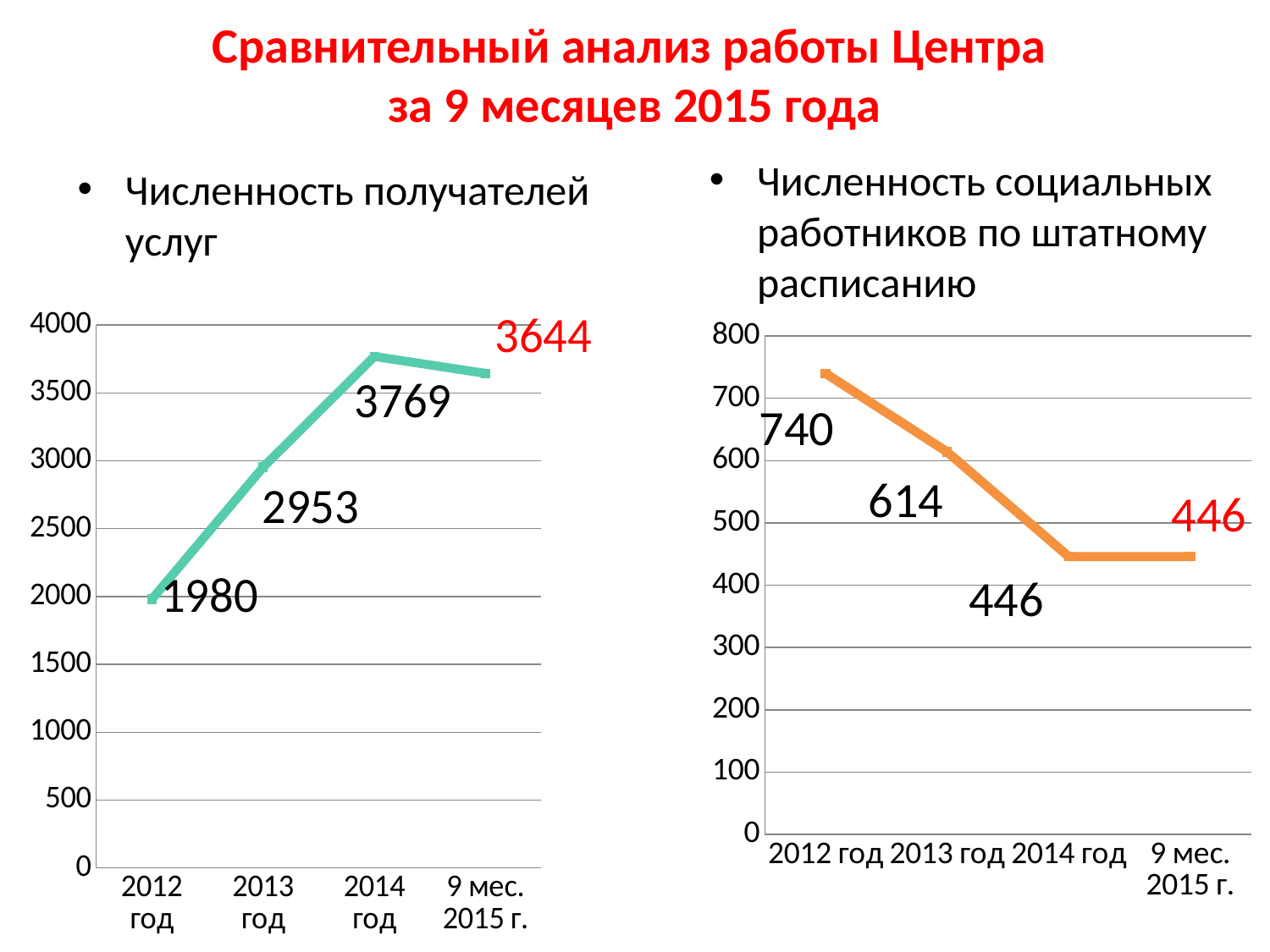
What kind of chart is the right chart (Численность социальных работников по штатному расписанию)? line chart On the right chart (Численность социальных работников по штатному расписанию), what is the difference between the values for 2012 год and 2014 год? 294 On the left chart (Численность получателей услуг), what is the value for 2013 год? 2953 On the left chart (Численность получателей услуг), what is the difference between the values for 2014 год and 2012 год? 1789 On the left chart (Численность получателей услуг), how many data points are plotted? 4 On the right chart (Численность социальных работников по штатному расписанию), do the values rise or fall from 2012 год to 2014 год? fall On the left chart (Численность получателей услуг), which category has the highest value? 2014 год On the right chart (Численность социальных работников по штатному расписанию), what is the value for 2012 год? 740 On the left chart (Численность получателей услуг), what is the value for 9 мес. 2015 г.? 3644 On the right chart (Численность социальных работников по штатному расписанию), what is the value for 2013 год? 614 On the left chart (Численность получателей услуг), which category has the lowest value? 2012 год On the right chart (Численность социальных работников по штатному расписанию), which is larger: the value for 2013 год or the value for 9 мес. 2015 г.? 2013 год